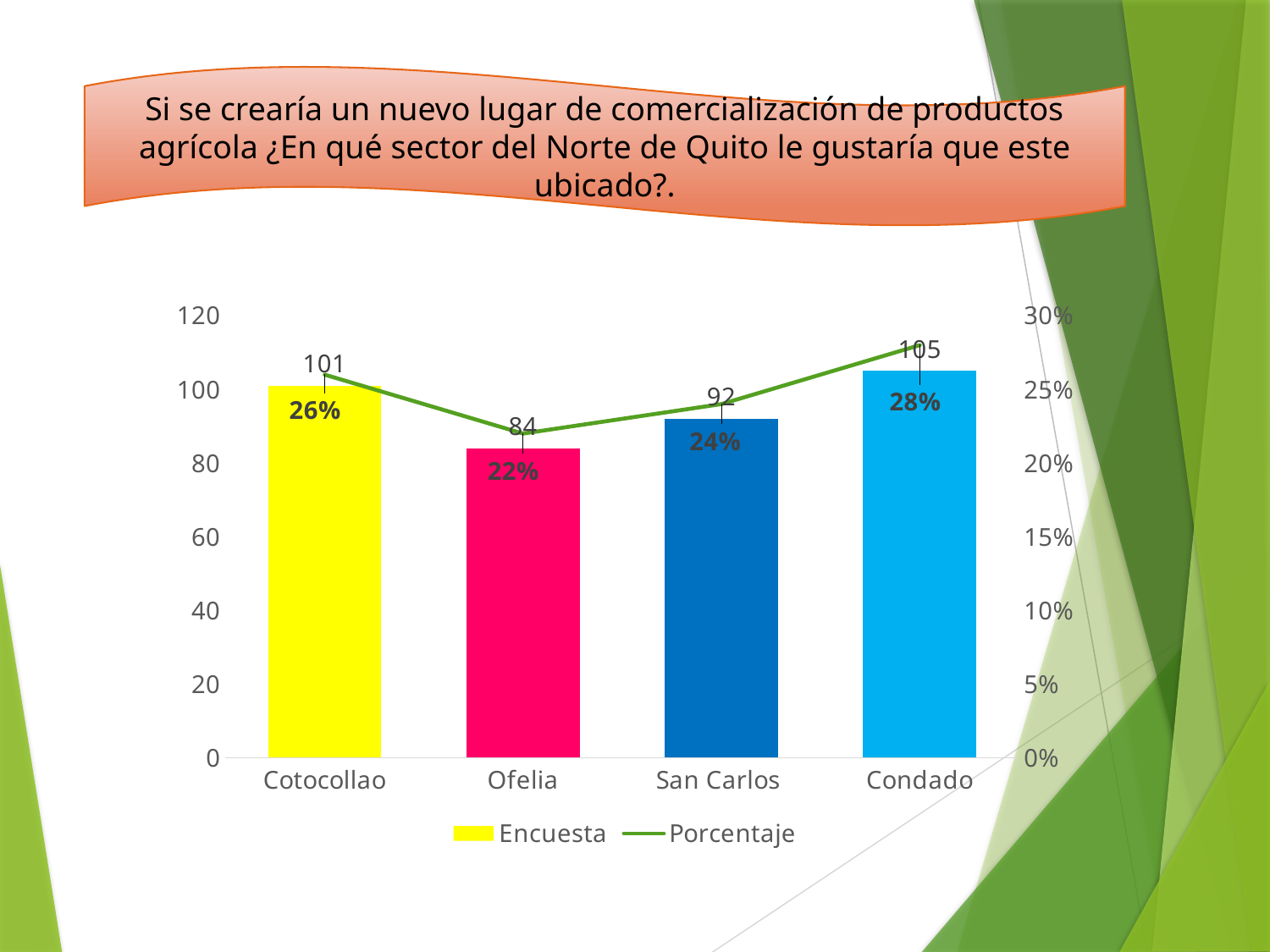
What colour is the bar for Ofelia? Pink Which sector has the lowest Encuesta value? Ofelia What is the Encuesta value for Cotocollao? 101 How many sectors are shown on the x axis? 4 What kind of chart is used for the Encuesta series? Bar chart How many series does the legend list? 2 Which has a larger Encuesta value, Cotocollao or San Carlos? Cotocollao Which sector has the highest Encuesta value? Condado What is the Porcentaje value for San Carlos? 24% What is the Porcentaje value for Condado? 28% What is the difference between the Encuesta values for Condado and Ofelia? 21 What is the Encuesta value for Ofelia? 84